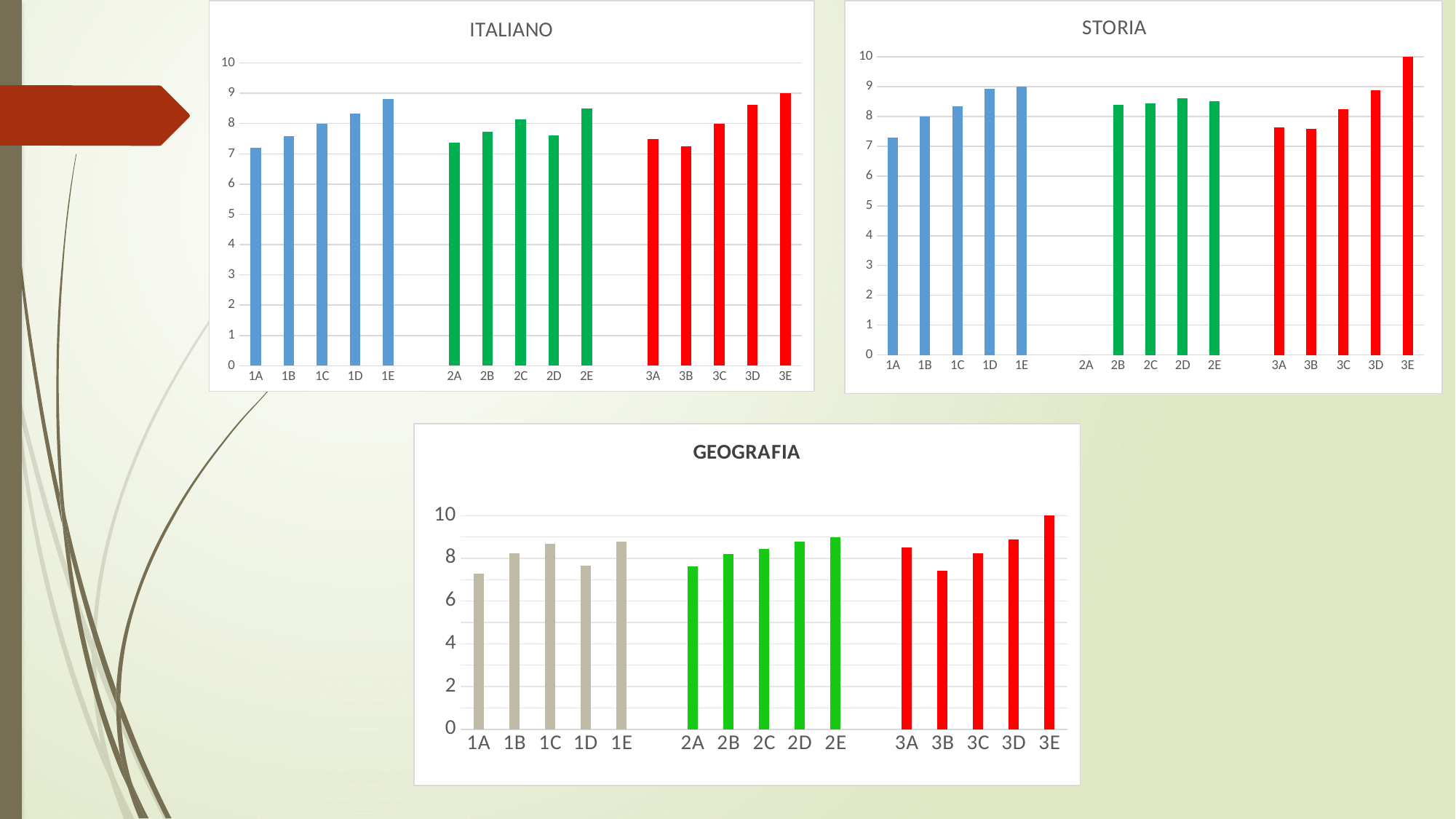
In the STORIA chart, what is the value for 3E? 10 In the ITALIANO chart, which category has the highest value? 3E In the STORIA chart, is the value for 1D greater or less than 8? greater In the STORIA chart, which category label has no bar plotted? 2A In the STORIA chart, which category has the highest value? 3E In the ITALIANO chart, how many categories are shown on the x axis? 15 In the GEOGRAFIA chart, is the value for 3B greater or less than 8? less In the ITALIANO chart, do the values rise or fall from 1A to 1E? rise In the GEOGRAFIA chart, which category has the highest value? 3E In the ITALIANO chart, is the value for 1A greater or less than 8? less What kind of chart is the ITALIANO chart? bar chart In the ITALIANO chart, which is larger, the value for 1E or the value for 2A? 1E